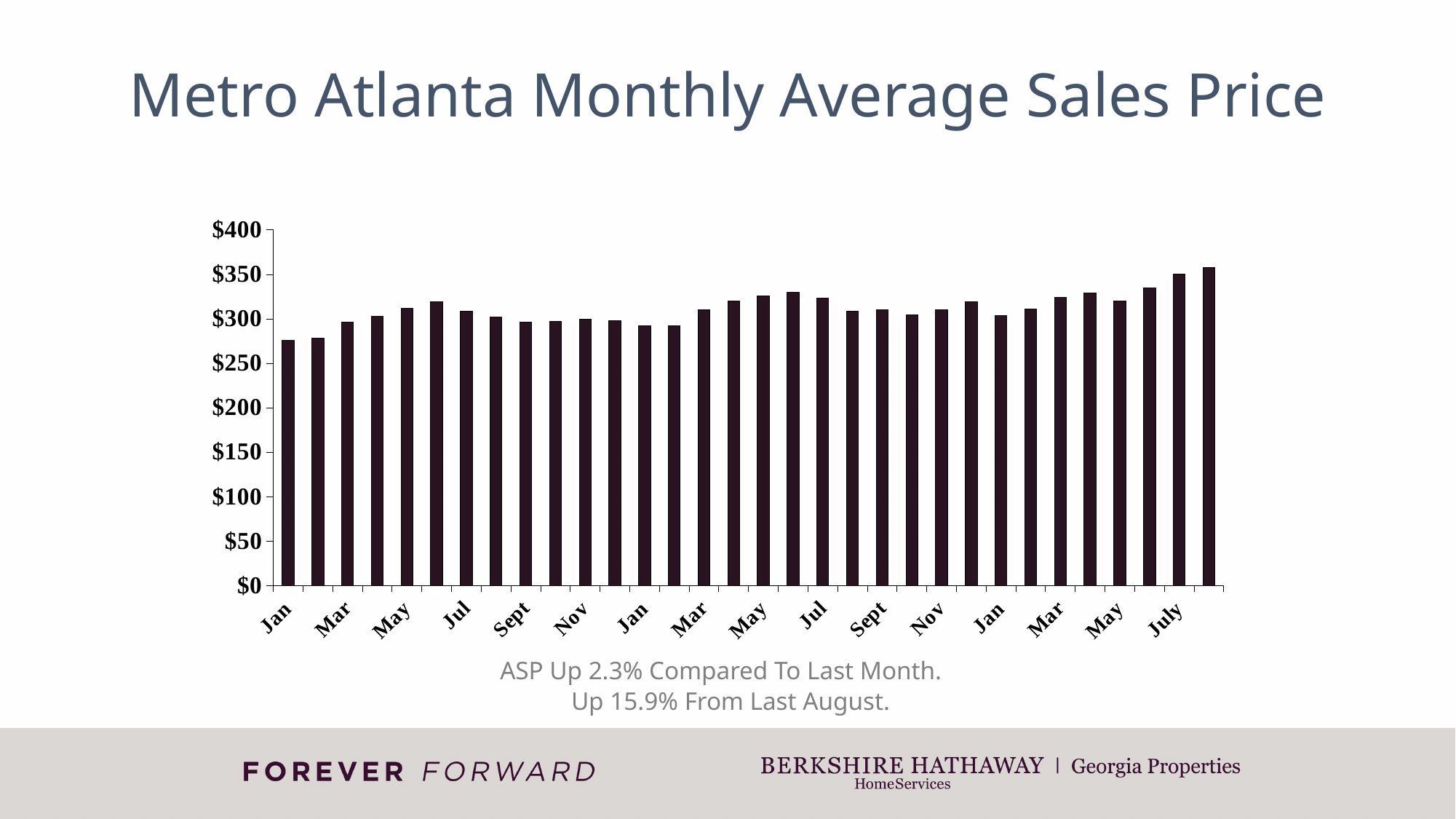
Overall, do the values rise or fall from the first bar to the last bar? rise What kind of chart is shown on the slide? bar chart According to the text below the chart, by what percentage is ASP up compared to last month? 2.3% Is the value for the first Jan bar greater or less than $300? less What is the title of the chart? Metro Atlanta Monthly Average Sales Price Which is larger, the first bar (Jan of the first year) or the last bar in the chart? the last bar Is the value for the May bar in the second year greater or less than $300? greater How many bars are plotted in the chart? 32 Which is larger, the Mar bar in the first year or the Mar bar in the third year? the Mar bar in the third year Is the value for the first Jan bar greater or less than $250? greater Which bar is the highest in the chart? the last bar (August of the final year)